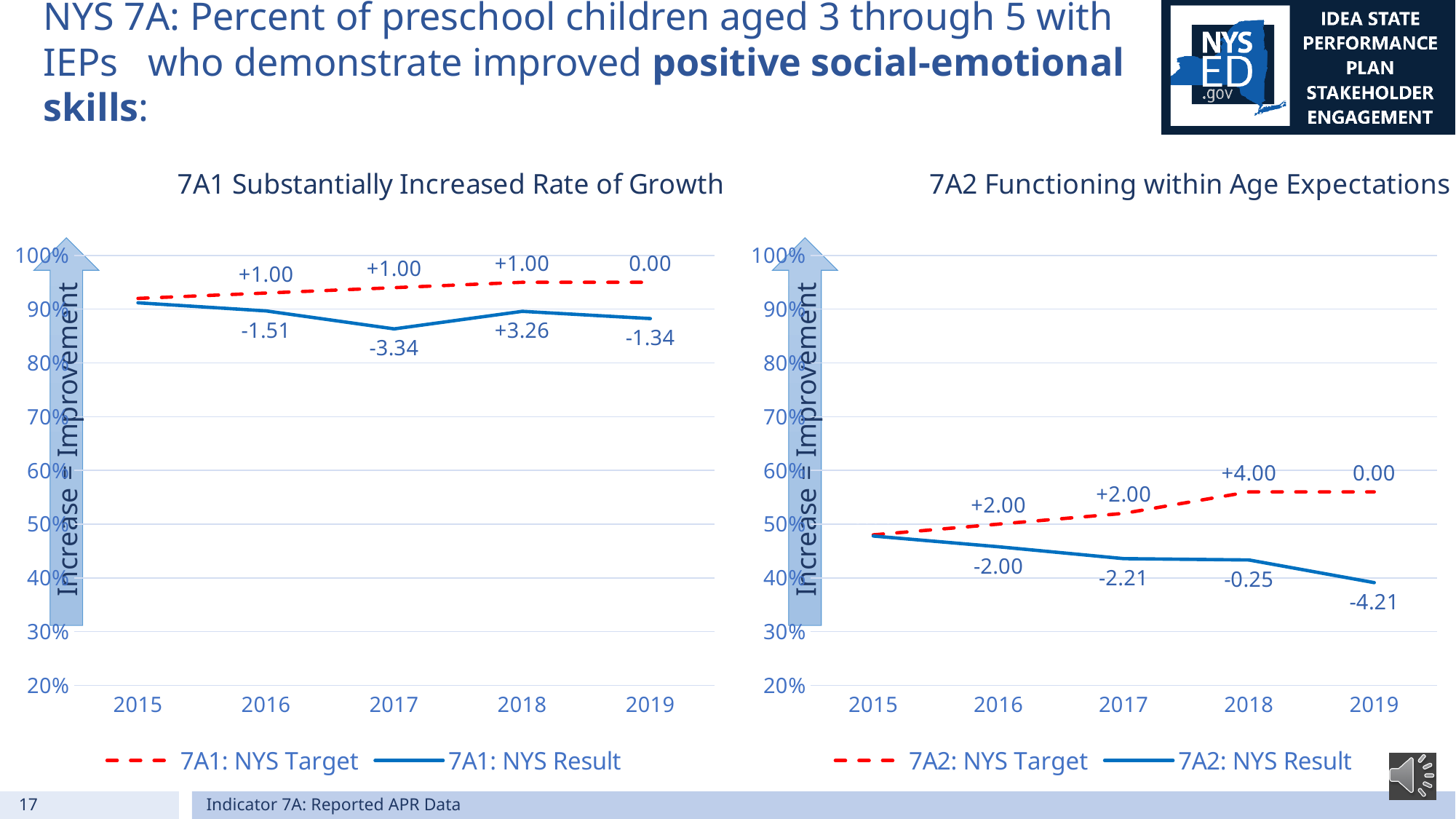
In the 7A1 Substantially Increased Rate of Growth chart, what change label is shown for the 7A1: NYS Result in 2018? +3.26 How many series does the legend of the 7A1 Substantially Increased Rate of Growth chart list? 2 In the 7A1 Substantially Increased Rate of Growth chart, is the 7A1: NYS Result value for 2017 greater or less than 80%? greater How many years are shown on the x axis of the 7A2 Functioning within Age Expectations chart? 5 What type of chart is the 7A1 Substantially Increased Rate of Growth chart? line chart In the 7A2 Functioning within Age Expectations chart, does the 7A2: NYS Result line rise or fall from 2015 to 2019? fall In the 7A2 Functioning within Age Expectations chart, which year has the lowest 7A2: NYS Result value? 2019 In the 7A1 Substantially Increased Rate of Growth chart, which is higher in 2017, the 7A1: NYS Target or the 7A1: NYS Result? 7A1: NYS Target In the 7A2 Functioning within Age Expectations chart, is the 7A2: NYS Result value for 2019 greater or less than 50%? less In the 7A2 Functioning within Age Expectations chart, what change label is shown for the 7A2: NYS Result in 2019? -4.21 In the 7A2 Functioning within Age Expectations chart, what change label is shown for the 7A2: NYS Target in 2018? +4.00 In the 7A1 Substantially Increased Rate of Growth chart, what change label is shown for the 7A1: NYS Result in 2017? -3.34